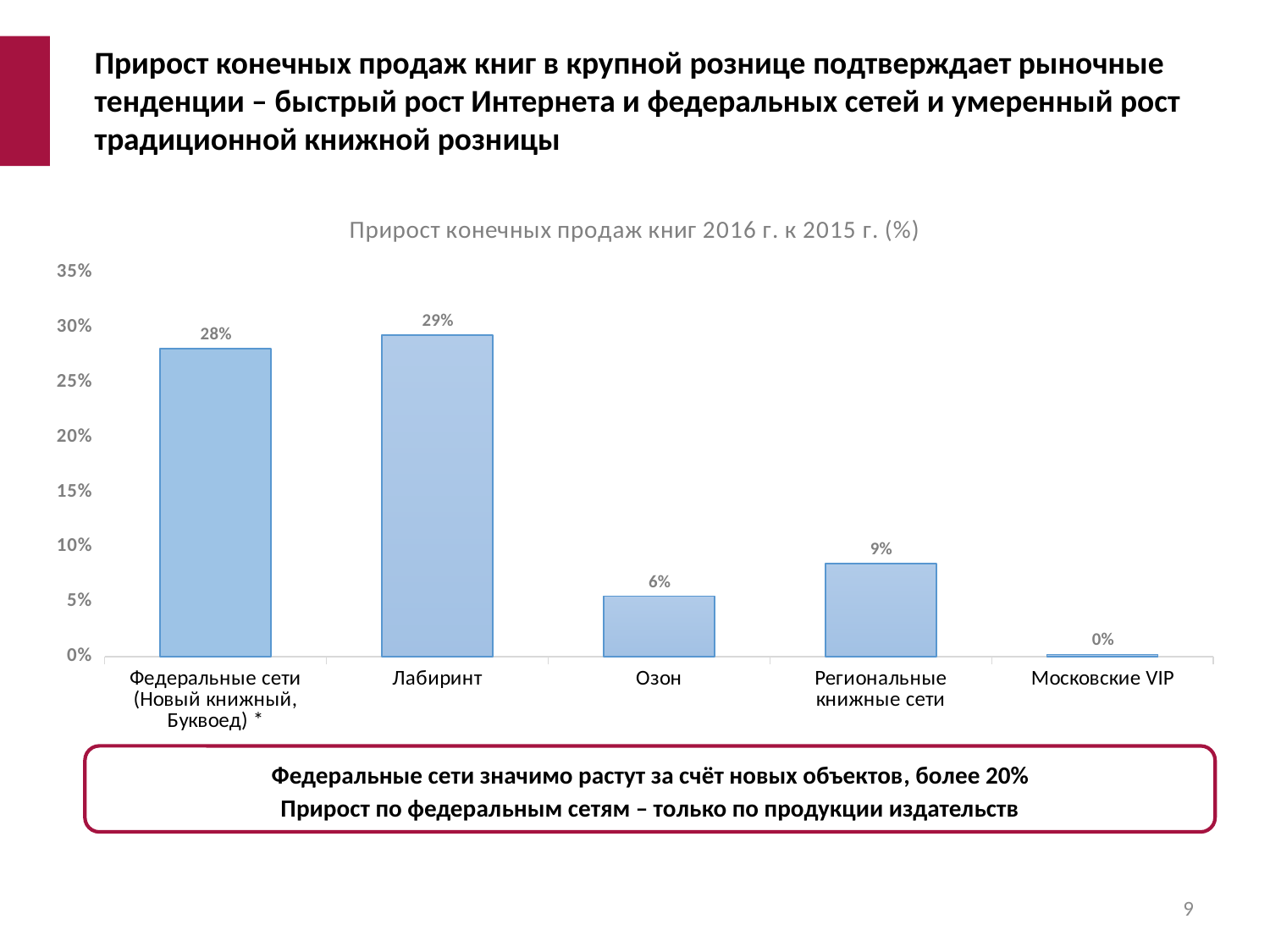
What is the value for Лабиринт? 29% What is the value for Озон? 6% How many categories are shown on the x axis? 5 What is the value for Региональные книжные сети? 9% Which category has the highest value? Лабиринт Is the value for Федеральные сети (Новый книжный, Буквоед) greater or less than 25%? greater What is the difference between the values for Лабиринт and Озон? 23% What is the value for Московские VIP? 0% What kind of chart is shown on the slide? bar chart What is the title of the chart? Прирост конечных продаж книг 2016 г. к 2015 г. (%) Which is larger, the value for Региональные книжные сети or the value for Озон? Региональные книжные сети Which category has the lowest value? Московские VIP